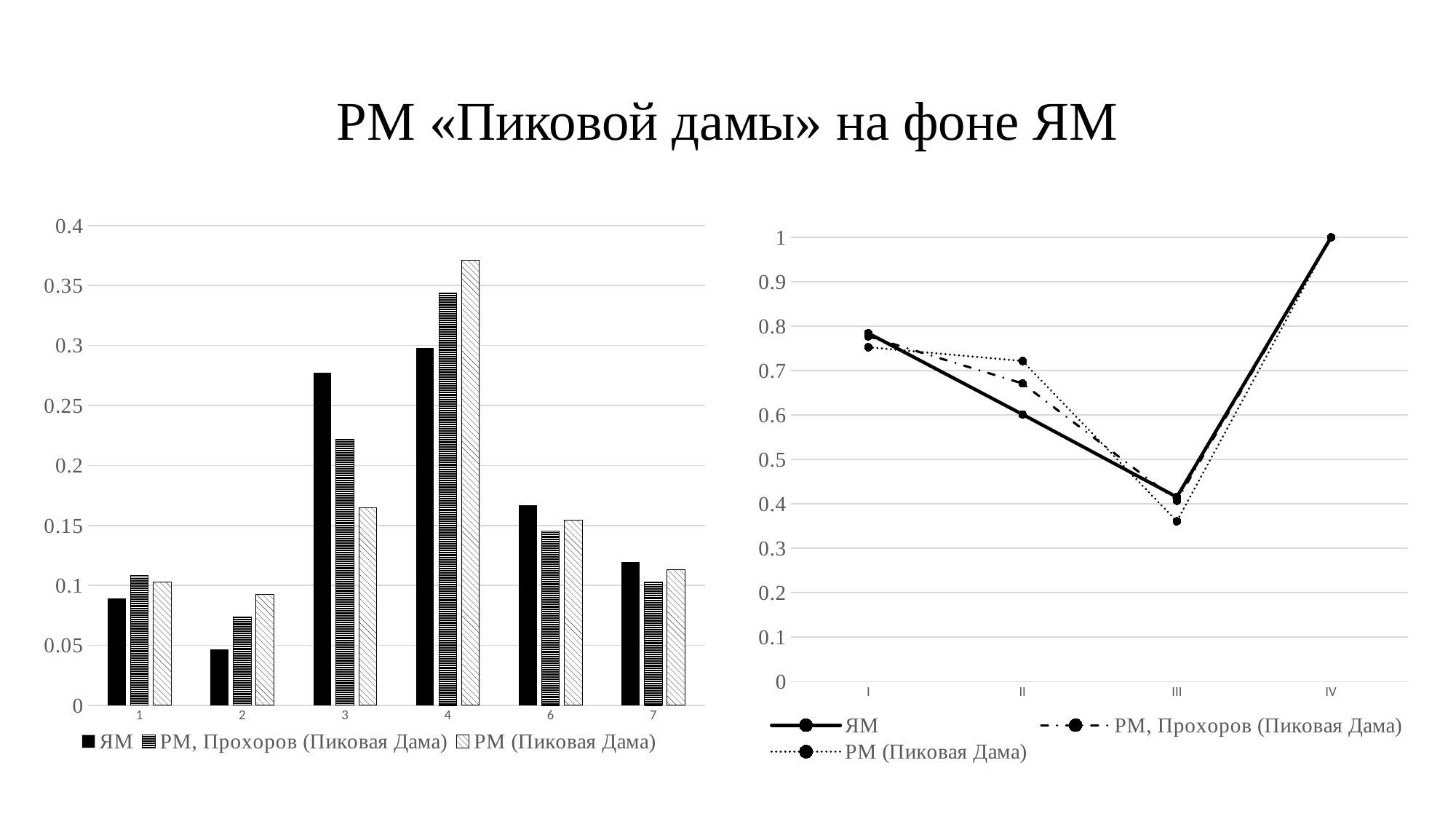
In the bar chart on the left, is the value for ЯМ at category 3 greater or less than 0.25? greater In the line chart on the right, how many points are plotted on the x axis for each series? 4 In the bar chart on the left, how many series does the legend list? 3 In the bar chart on the left, is the value for РМ (Пиковая Дама) at category 4 greater or less than 0.35? greater In the line chart on the right, at which point does the ЯМ series reach its lowest value? III What kind of chart is the chart on the right of the slide? line chart In the line chart on the right, is the value for РМ (Пиковая Дама) at III greater or less than 0.4? less In the bar chart on the left, which category has the highest value for РМ (Пиковая Дама)? 4 What kind of chart is the chart on the left of the slide? bar chart In the bar chart on the left, at category 3, which series has the larger value: ЯМ or РМ (Пиковая Дама)? ЯМ In the bar chart on the left, how many categories are shown on the x axis? 6 In the bar chart on the left, which category has the lowest value for ЯМ? 2